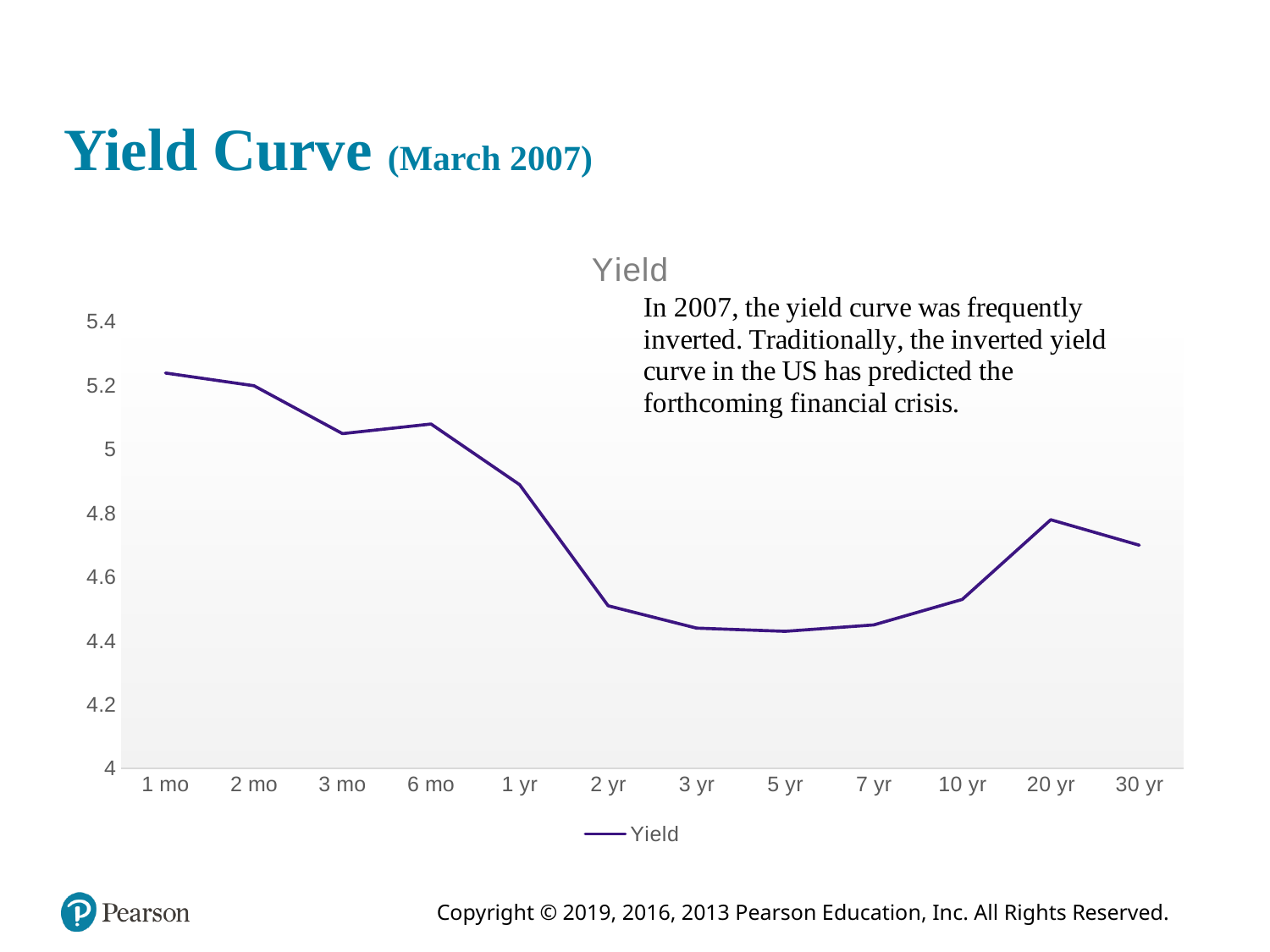
Is the yield for 1 mo greater or less than 5? greater Is the yield for 2 yr greater or less than 4.6? less How many series does the legend of the Yield chart list? 1 Which has the higher yield, 10 yr or 20 yr? 20 yr Is the yield for 1 yr greater or less than 5? less How many maturities are plotted along the x axis of the Yield chart? 12 What is the title of the chart? Yield Which has the higher yield, 1 mo or 30 yr? 1 mo Does the yield rise or fall from 1 mo to 5 yr? fall What kind of chart is shown on the slide? line chart Which maturity has the highest yield on the chart? 1 mo